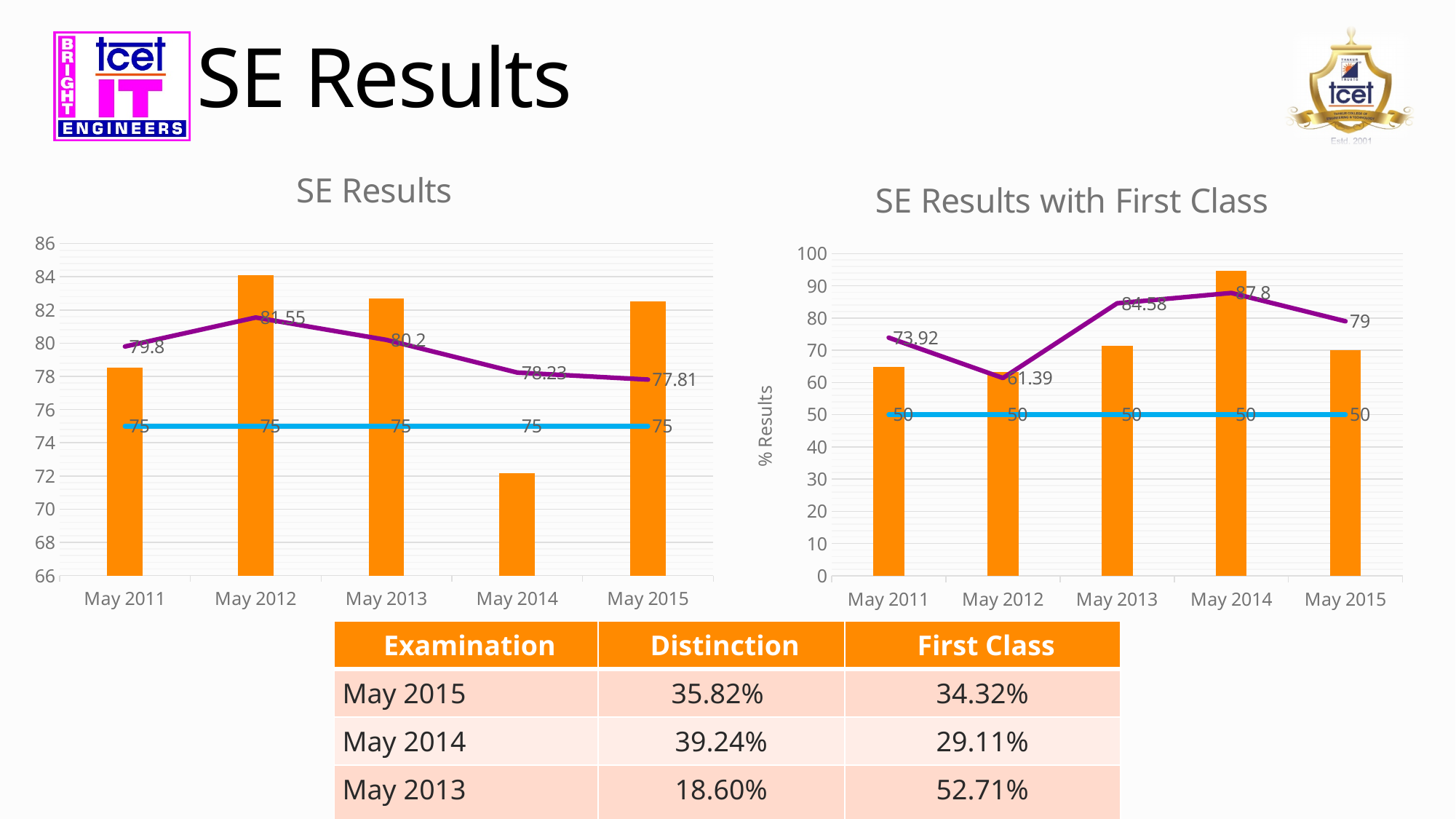
What is the y-axis title of the 'SE Results with First Class' chart? % Results In the 'SE Results' chart, what value does the purple line show for May 2015? 77.81 In the 'SE Results with First Class' chart, what value does the purple line show for May 2014? 87.8 In the 'SE Results' chart, which year has the tallest orange bar? May 2012 In the 'SE Results with First Class' chart, how many years are shown on the x axis? 5 In the 'SE Results' chart, which year has the highest value on the purple line? May 2012 In the 'SE Results with First Class' chart, is the orange bar for May 2014 greater or less than 90? greater In the 'SE Results' chart, what constant value does the blue line show? 75 In the 'SE Results' chart, what value does the purple line show for May 2012? 81.55 In the 'SE Results' chart, is the orange bar for May 2014 greater or less than 74? less In the 'SE Results with First Class' chart, which year has the lowest value on the purple line? May 2012 In the 'SE Results' chart, what is the difference between the purple line values for May 2012 and May 2015? 3.74